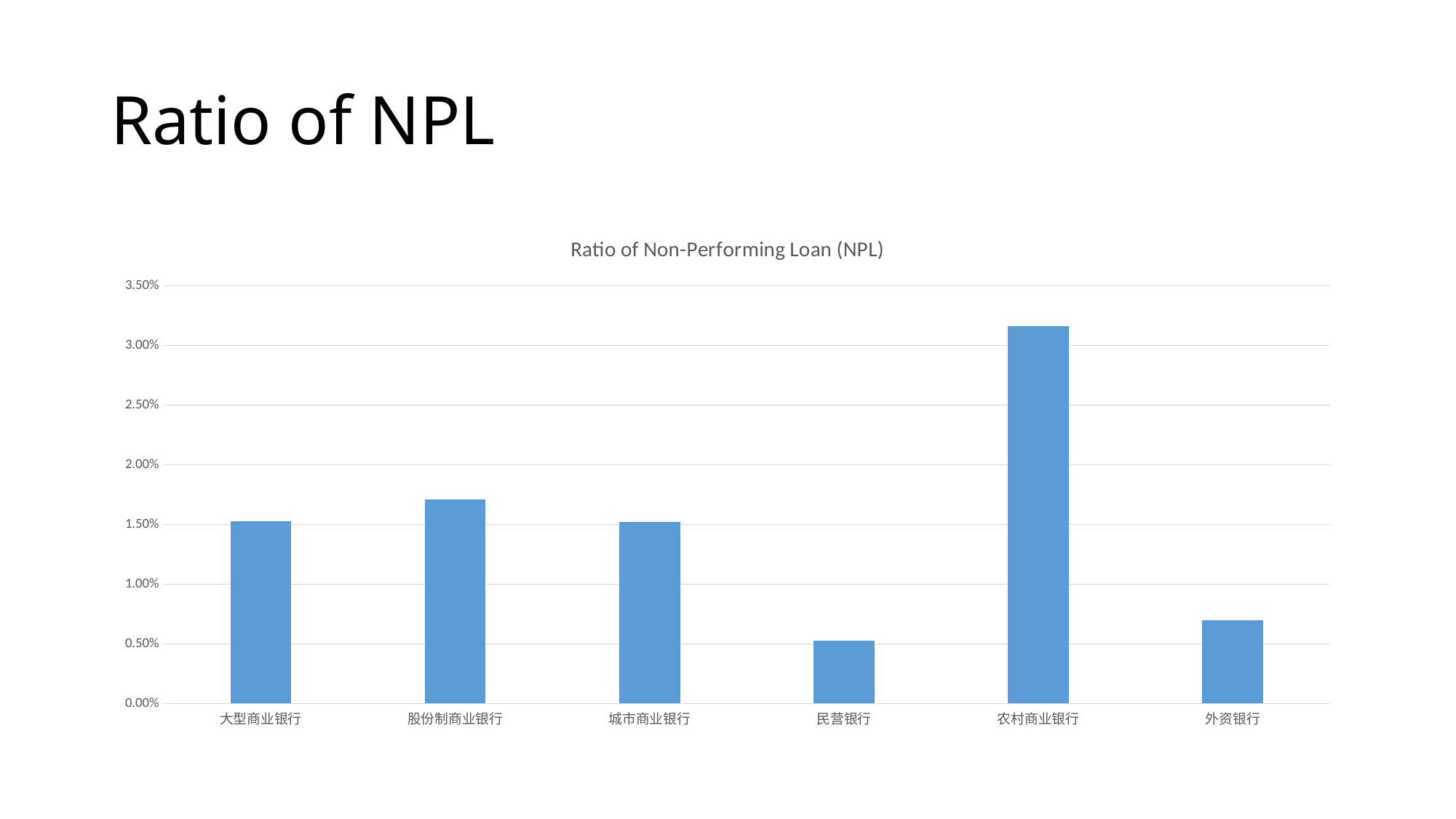
What is the highest value shown on the vertical axis? 3.50% Is the NPL ratio for 股份制商业银行 greater or less than 1.50%? greater Which bank category has the highest NPL ratio? 农村商业银行 Which has a higher NPL ratio, 民营银行 or 外资银行? 外资银行 Which has a higher NPL ratio, 外资银行 or 城市商业银行? 城市商业银行 Is the NPL ratio for 农村商业银行 greater or less than 3.00%? greater Is the NPL ratio for 外资银行 greater or less than 1.00%? less How many bank categories are plotted in the chart? 6 What kind of chart is shown on the slide? bar chart What is the title of the chart? Ratio of Non-Performing Loan (NPL) Which bank category has the lowest NPL ratio? 民营银行